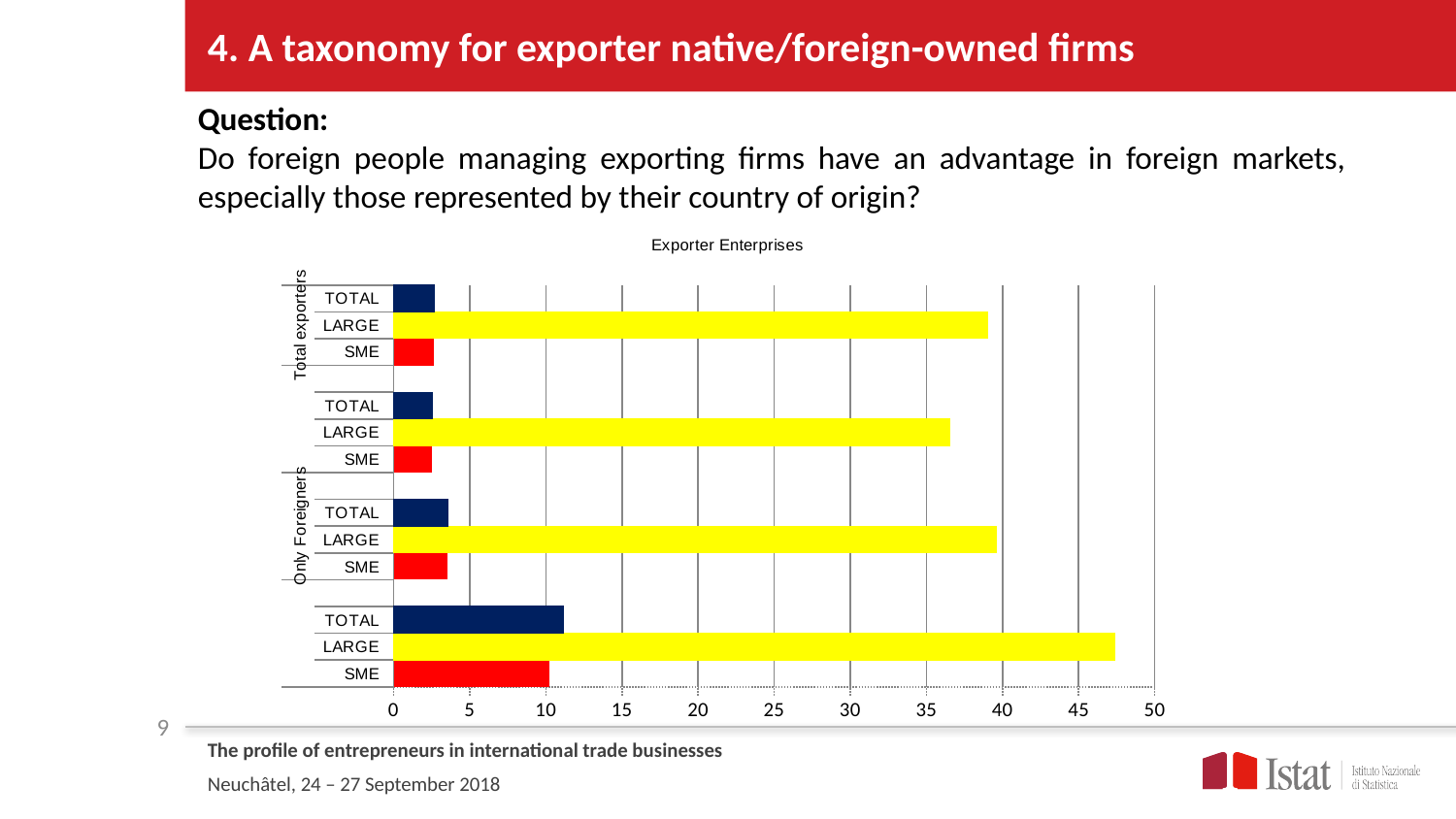
Which bar in the chart has the highest value? LARGE in the bottom group What kind of chart is shown on the slide? bar chart In the Only Foreigners group, which is larger, LARGE or SME? LARGE What colour are the LARGE bars in the chart? yellow How many bars are plotted in the chart? 12 Is the value for SME in the Total exporters group greater or less than 5? less Is the value for LARGE in the Total exporters group greater or less than 35? greater Is the value for LARGE in the Only Foreigners group greater or less than 35? greater What is the title of the chart? Exporter Enterprises